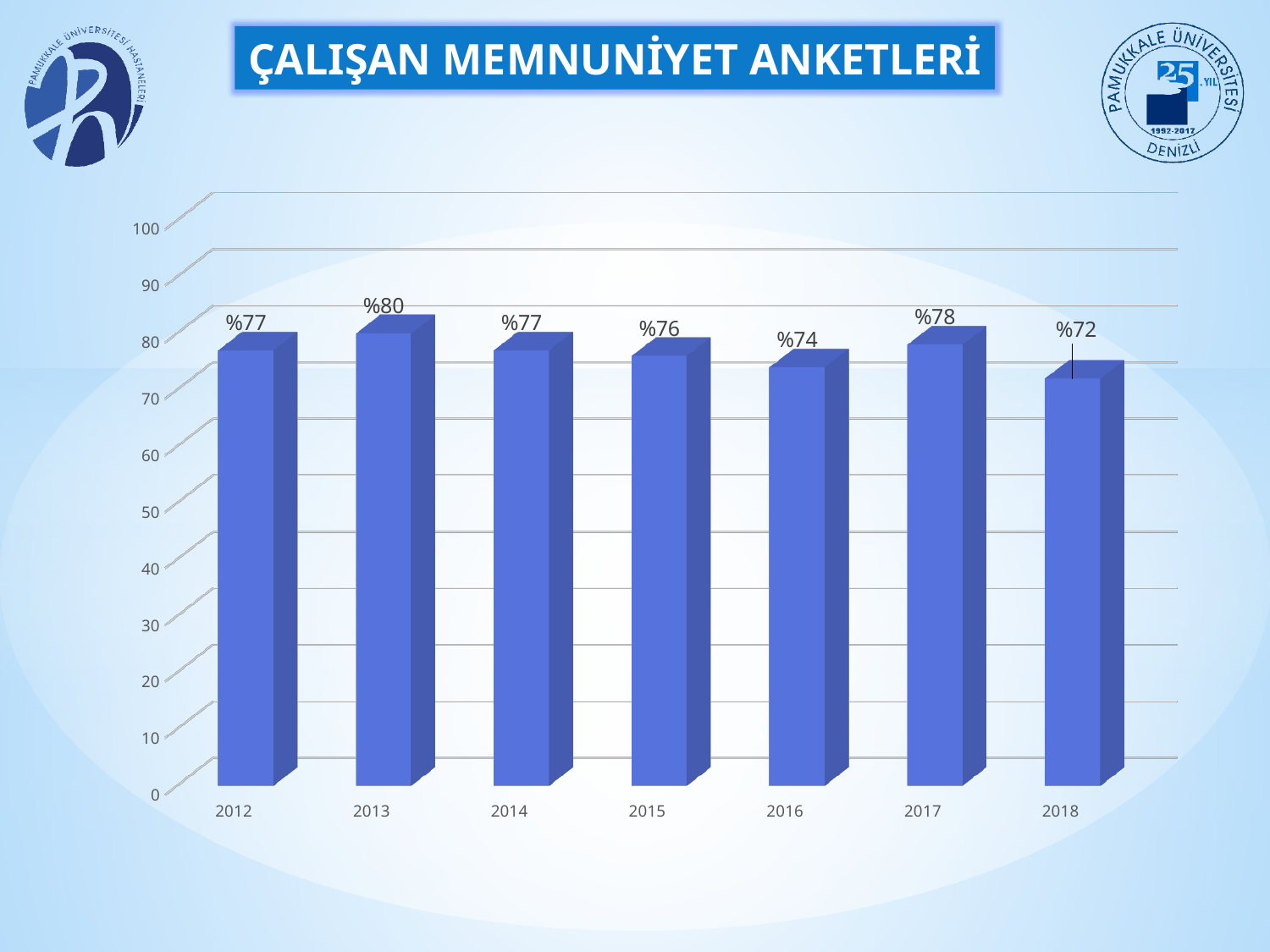
What is the difference between the values for 2013 and 2018? 8 What kind of chart is shown on the slide? bar chart Which year has the lowest value? 2018 What is the value for 2016? %74 Do the values rise or fall from 2017 to 2018? fall Which year has the highest value? 2013 How many years are shown on the x axis? 7 Is the value for 2015 greater or less than 80? less Which is larger, the value for 2017 or the value for 2016? 2017 What is the value for 2013? %80 What is the value for 2018? %72 What is the title of the slide? ÇALIŞAN MEMNUNİYET ANKETLERİ